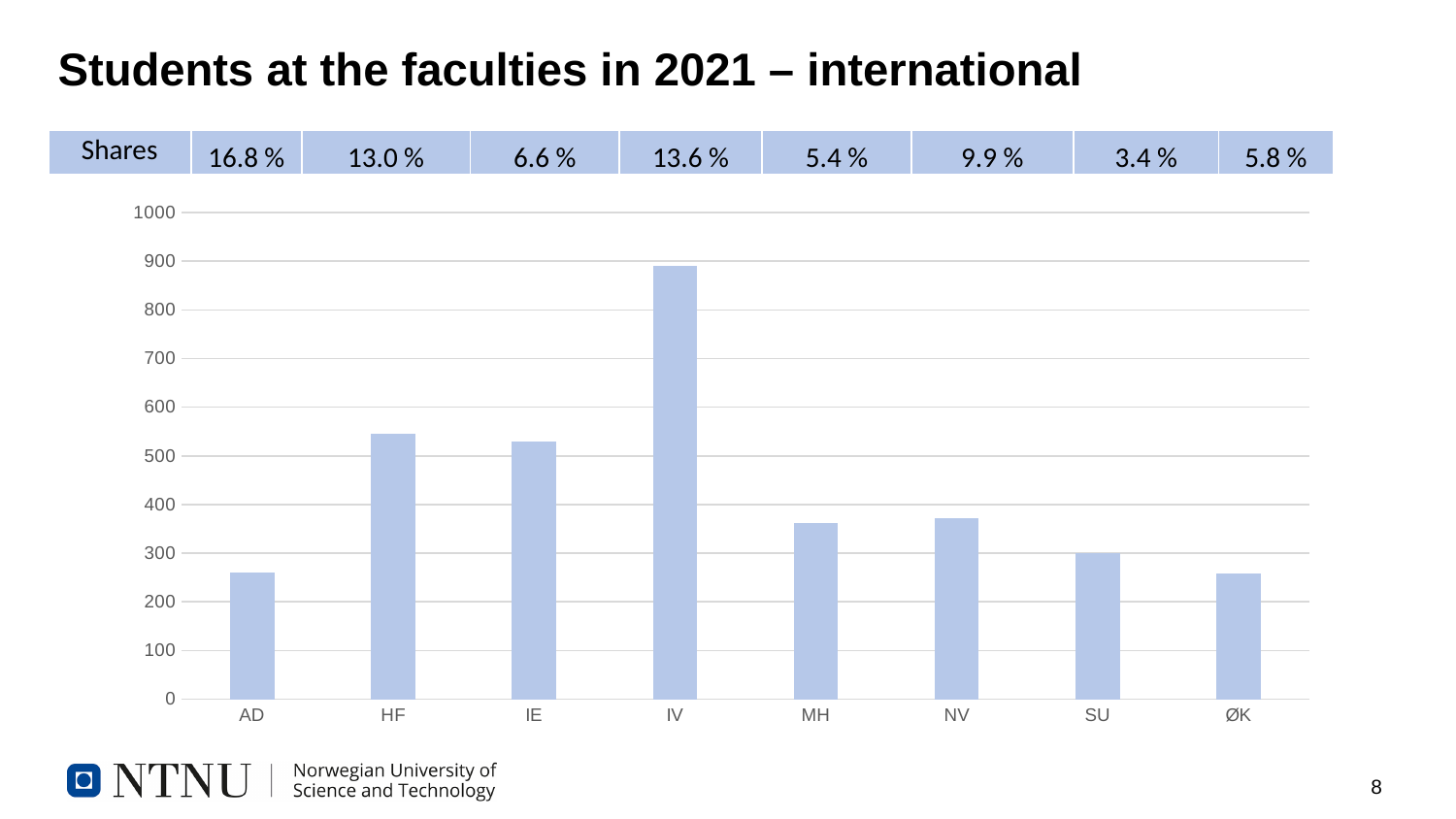
Is the value for HF greater or less than 500? greater How many faculties are shown on the x axis of the chart? 8 What share is shown in the Shares row for AD? 16.8 % Which has the larger bar, IV or HF? IV What share is shown in the Shares row for IV? 13.6 % What is the title of the chart on the slide? Students at the faculties in 2021 – international Which faculty has the highest bar in the chart? IV What kind of chart is shown on the slide? bar chart Is the value for IV greater or less than 800? greater Is the value for AD greater or less than 300? less Which faculty has the lowest value in the Shares row? SU